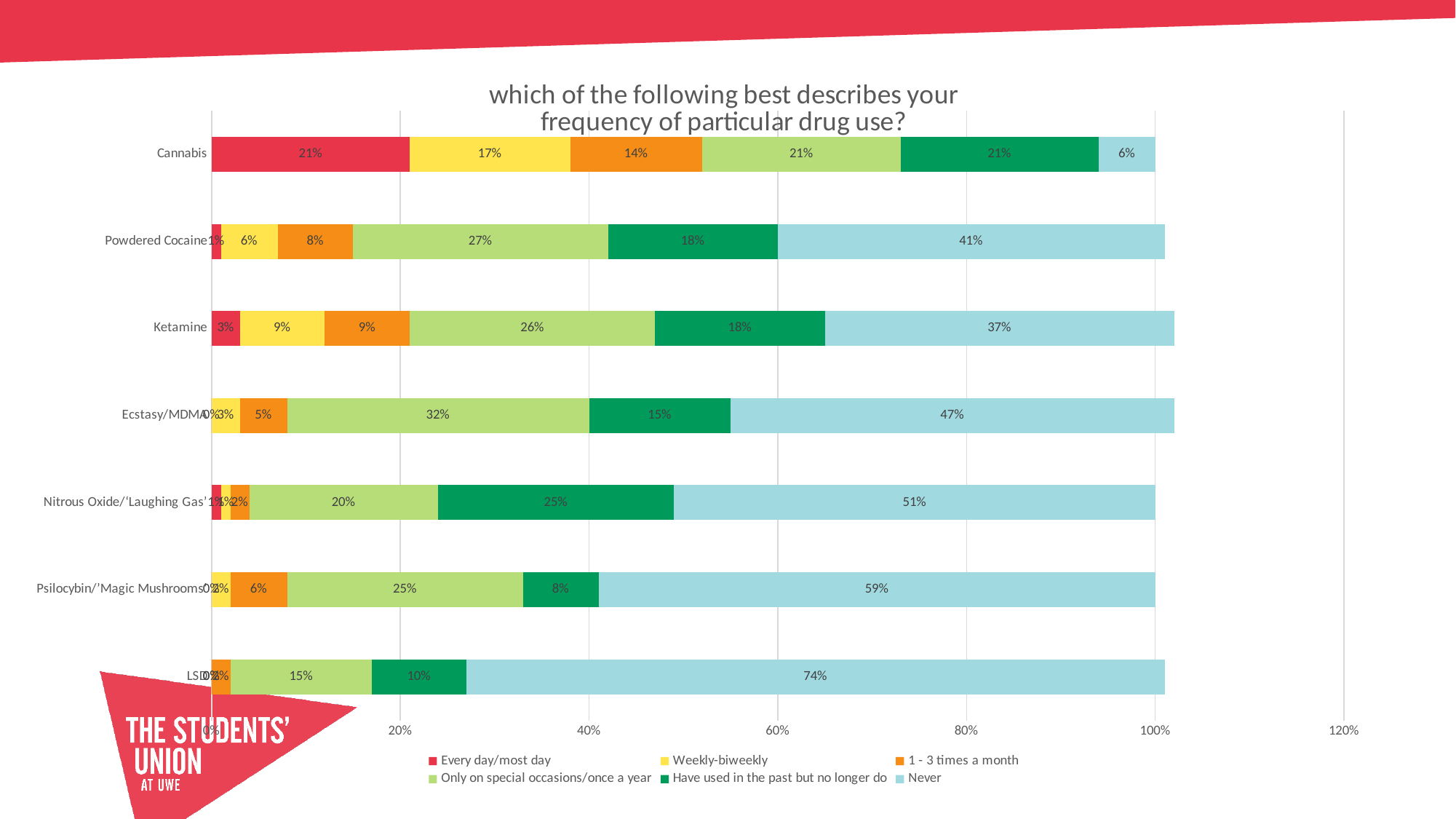
Which drug has the highest 'Never' percentage? LSD Which drug has the lowest 'Never' percentage? Cannabis What percentage of respondents answered 'Never' for LSD? 74% What is the 'Every day/most day' value for Cannabis? 21% Which has a larger 'Only on special occasions/once a year' value, Ecstasy/MDMA or Ketamine? Ecstasy/MDMA What is the 'Weekly-biweekly' value for Ketamine? 9% What is the title of the chart? which of the following best describes your frequency of particular drug use? What is the 'Have used in the past but no longer do' value for Nitrous Oxide/'Laughing Gas'? 25% How many drug categories are listed on the chart? 7 How many series does the legend list? 6 What is the difference between the 'Never' values for Psilocybin/'Magic Mushrooms' and Ketamine? 22 percentage points What kind of chart is shown on the slide? Stacked bar chart